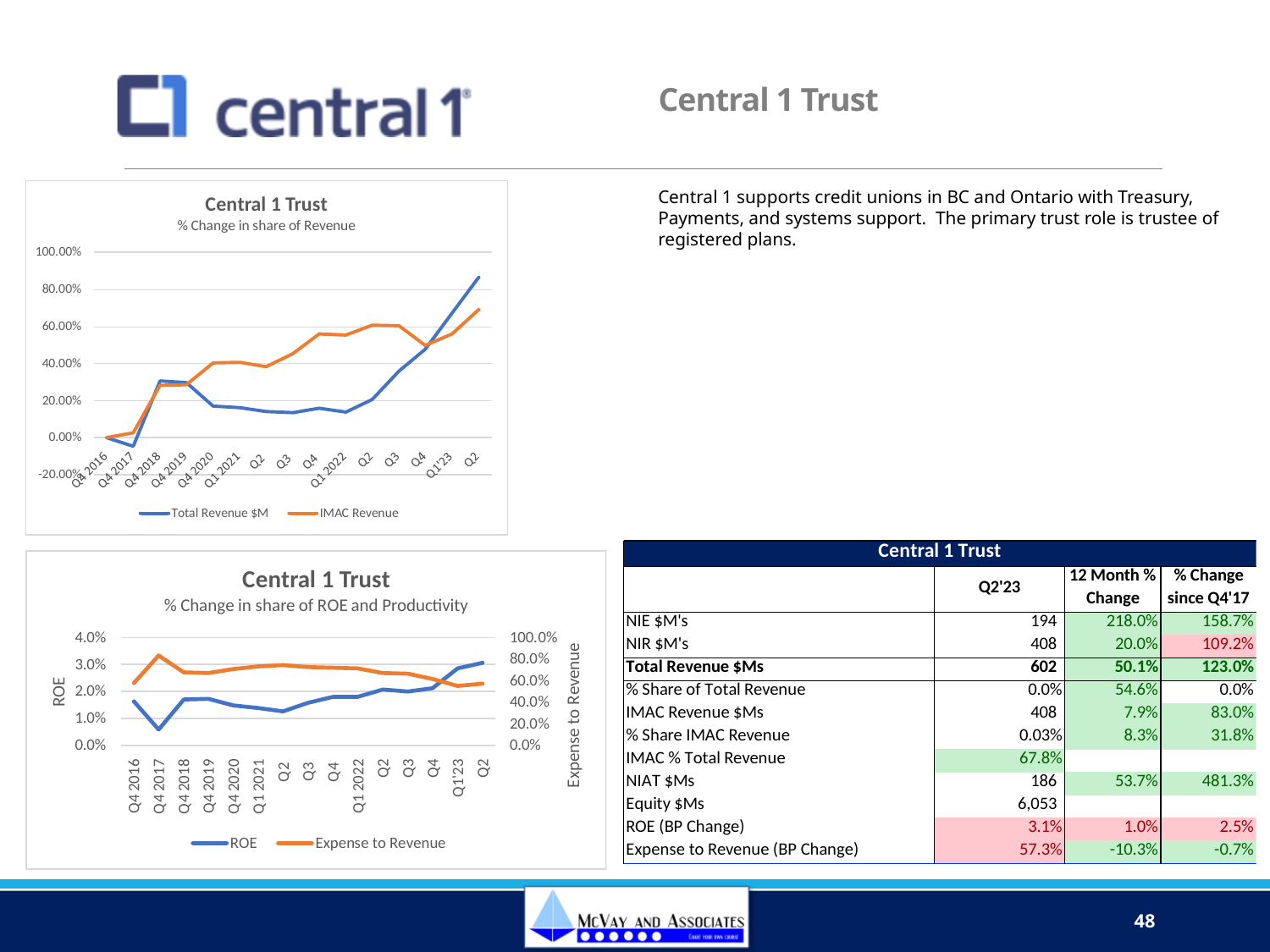
In the top-left chart (% Change in share of Revenue), which series has the higher value at Q4 2020, Total Revenue $M or IMAC Revenue? IMAC Revenue In the bottom-left chart (% Change in share of ROE and Productivity), is the ROE value at Q4 2017 greater or less than 1.0%? less In the top-left chart (% Change in share of Revenue), is the Total Revenue $M value at the final point (Q2) greater or less than 80.00%? greater In the top-left chart (% Change in share of Revenue), which series has the higher value at the final point (Q2), Total Revenue $M or IMAC Revenue? Total Revenue $M What are the two series named in the legend of the top-left chart (% Change in share of Revenue)? Total Revenue $M and IMAC Revenue What kind of chart is the top-left chart titled 'Central 1 Trust % Change in share of Revenue'? line chart In the top-left chart (% Change in share of Revenue), is the IMAC Revenue value at the final point (Q2) greater or less than 80.00%? less How many series does the legend of the top-left chart (% Change in share of Revenue) list? 2 How many points are plotted along the x axis of the top-left chart (% Change in share of Revenue)? 15 In the top-left chart (% Change in share of Revenue), does the Total Revenue $M line overall rise or fall from Q4 2016 to the final Q2? rise What are the two series named in the legend of the bottom-left chart (% Change in share of ROE and Productivity)? ROE and Expense to Revenue